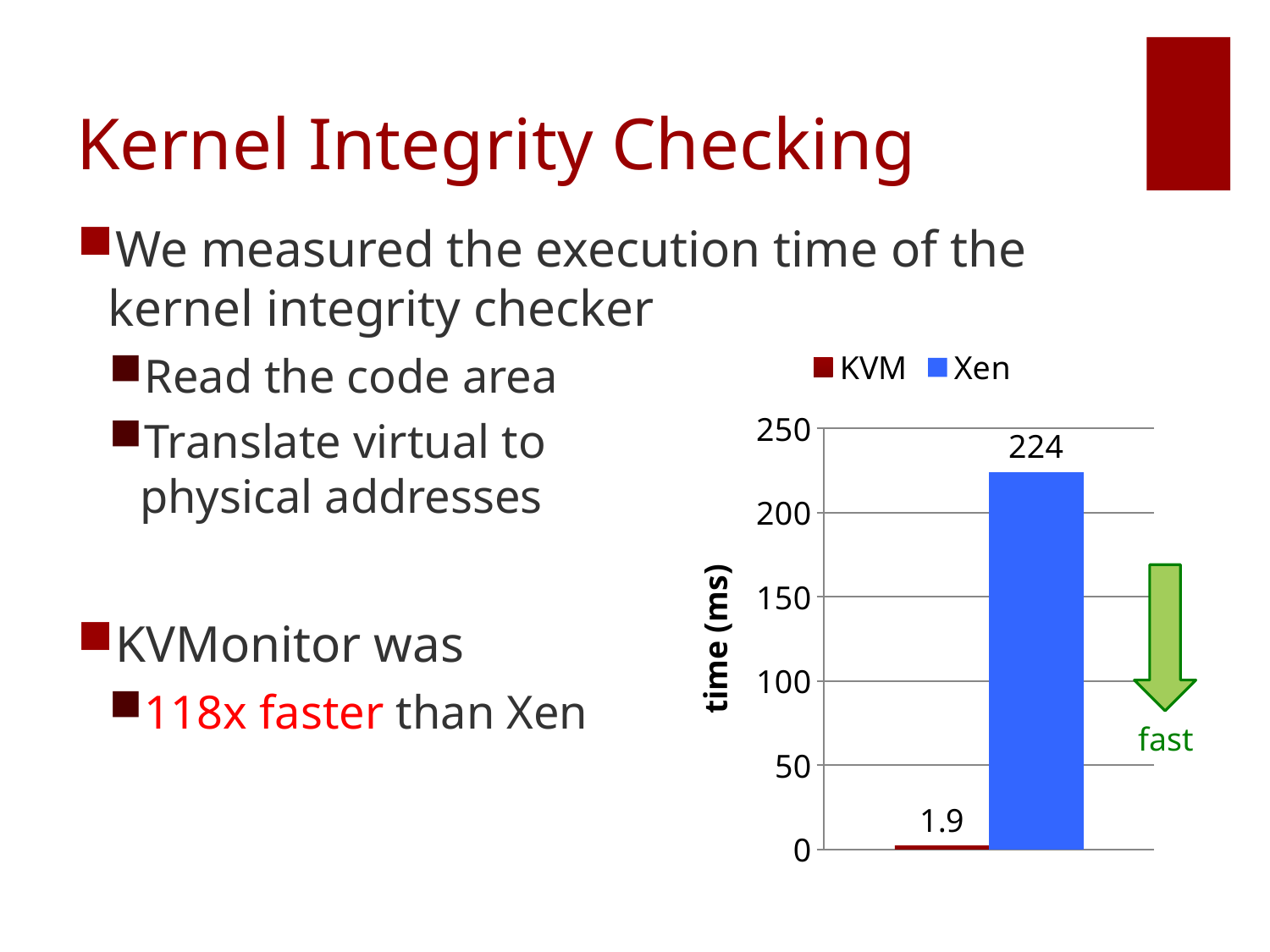
Which series has the highest execution time in the chart? Xen How many series does the chart legend list? 2 Which series has the lowest execution time in the chart? KVM What is the label of the vertical axis of the chart? time (ms) What is the difference in execution time between Xen and KVM? 222.1 Which series has the higher execution time, KVM or Xen? Xen What colour is the Xen bar in the chart? blue Is the value for KVM greater or less than 50? less What is the execution time for Xen in the chart? 224 What is the execution time for KVM in the chart? 1.9 What kind of chart is shown on the slide? bar chart Is the value for Xen greater or less than 200? greater